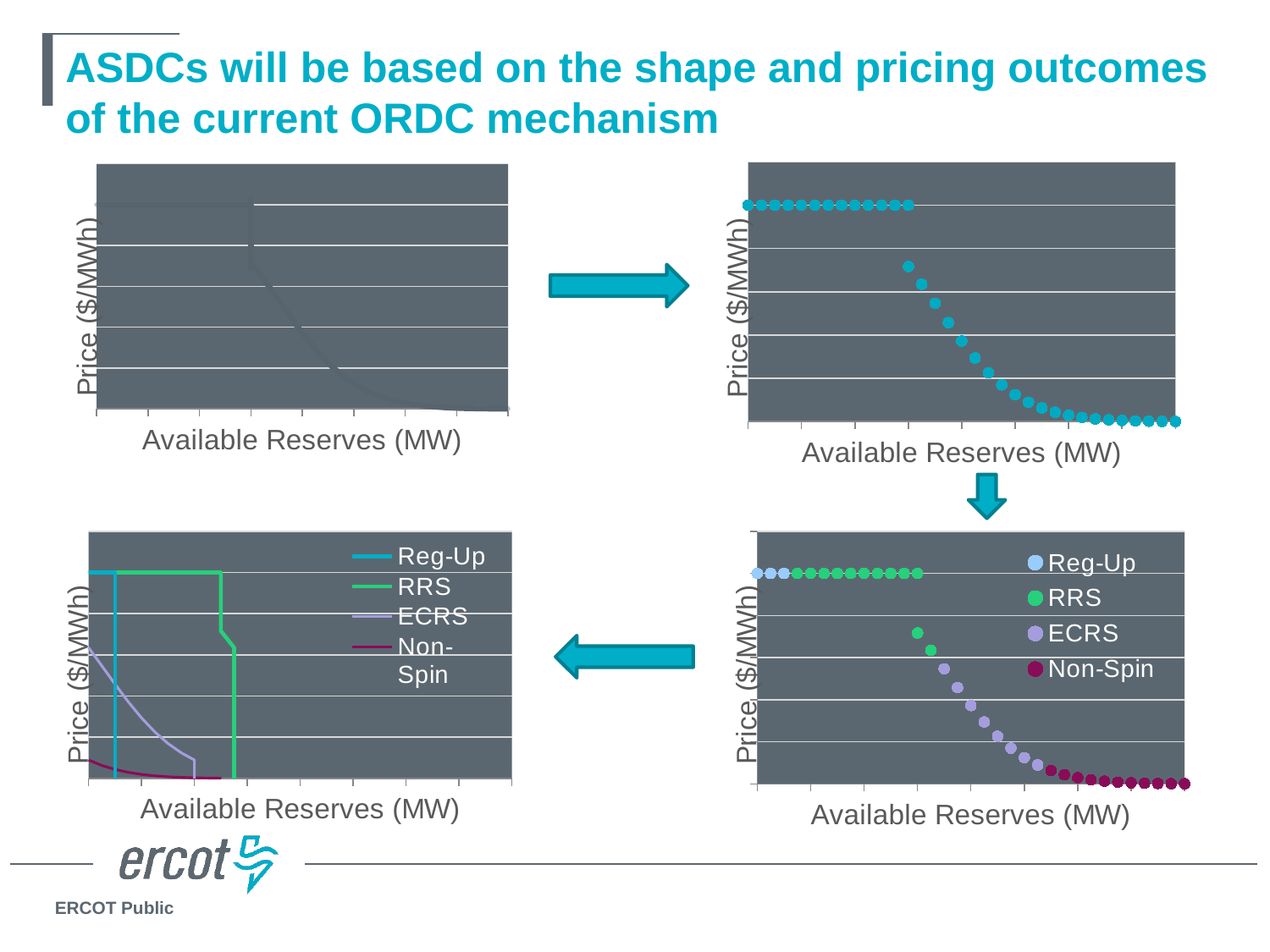
In the top-left chart, does the price rise or fall as available reserves increase? fall In the bottom-right chart, how many series does the legend list? 4 What kind of chart is the top-right chart? scatter chart In the bottom-right chart, which series is plotted with dark magenta dots? Non-Spin How many charts are shown on the slide? 4 In the bottom-left chart, which series is drawn in green? RRS In the bottom-left chart, how many series does the legend list? 4 In the bottom-left chart, does the ECRS line rise or fall as available reserves increase? fall What kind of chart is the top-left chart? line chart What kind of chart is the bottom-left chart? line chart In the bottom-left chart, which series has the higher price at low available reserves, Reg-Up or Non-Spin? Reg-Up In the top-right chart, do the plotted values rise or fall as available reserves increase? fall